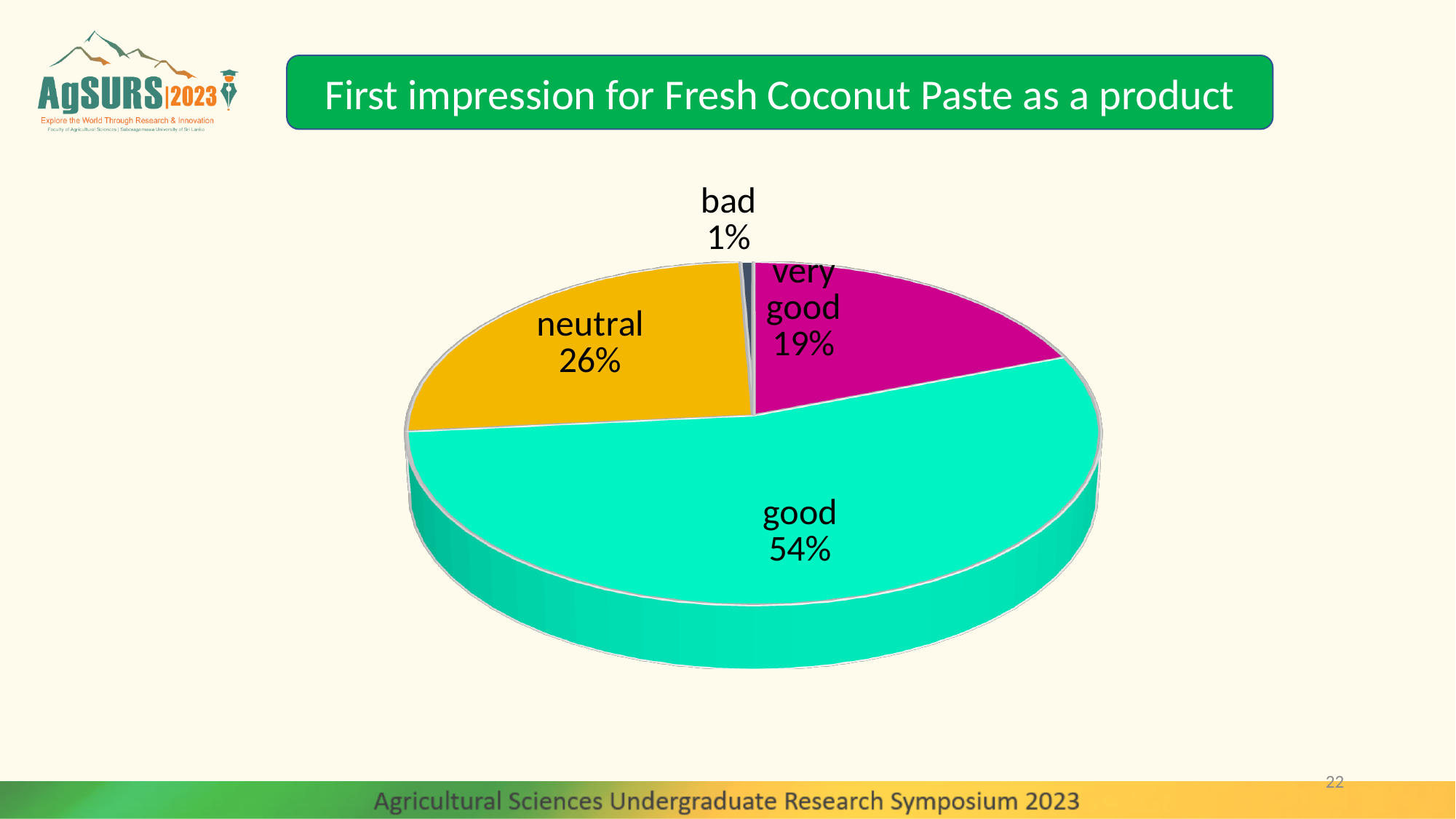
What kind of chart is shown on the slide? pie chart What is the difference in percentage points between "neutral" and "very good"? 7 Which category has the largest slice of the pie? good What percentage is shown for "neutral"? 26% What is the difference in percentage points between "good" and "neutral"? 28 Which category has the smallest slice of the pie? bad What percentage is shown for "bad"? 1% What percentage is shown for "very good"? 19% What share of the pie is labelled "good"? 54% Which is larger, the share for "very good" or the share for "neutral"? neutral What is the title of the chart on the slide? First impression for Fresh Coconut Paste as a product How many categories are shown in the pie chart? 4